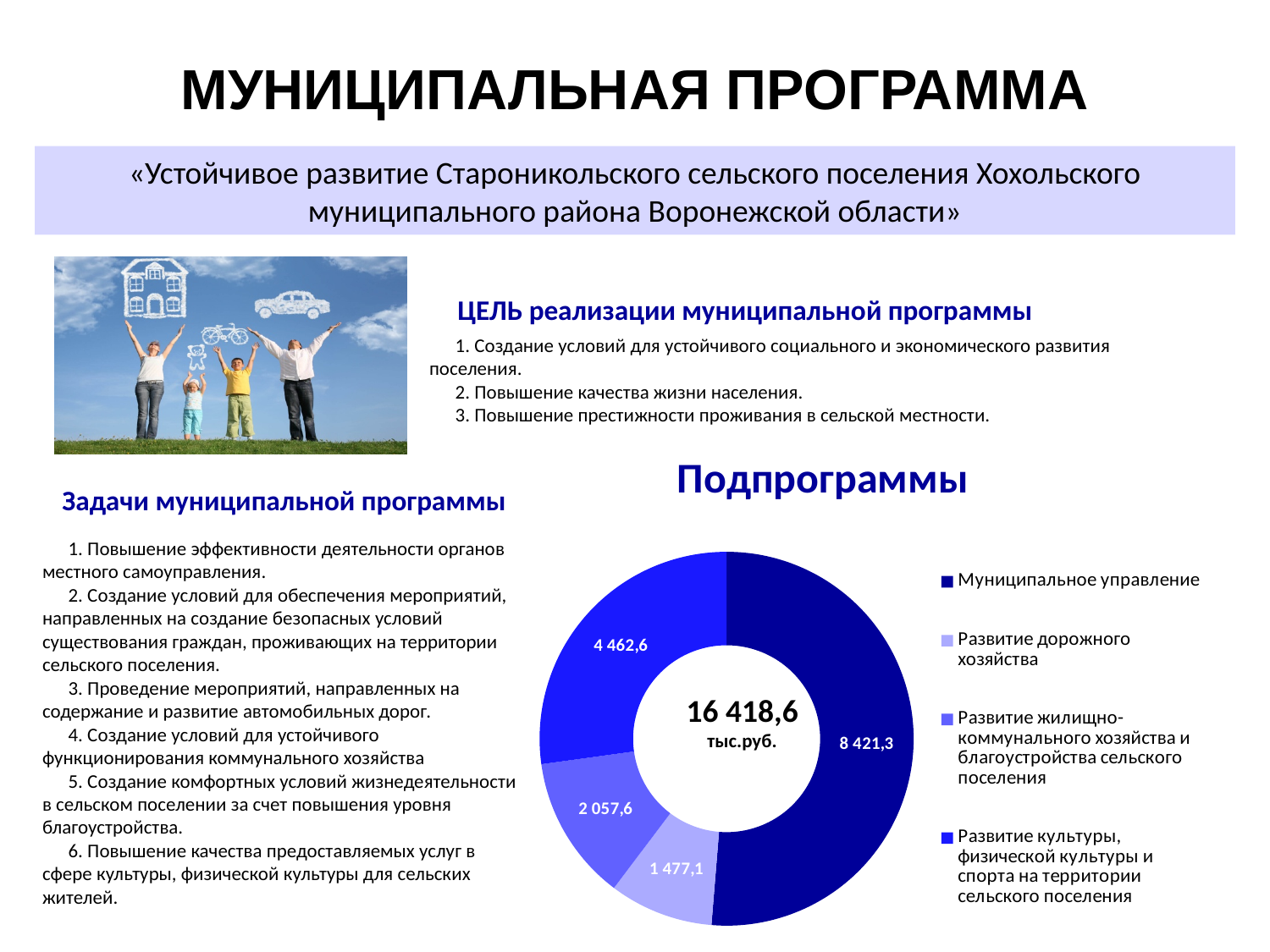
What total is shown in the centre of the «Подпрограммы» chart? 16 418,6 тыс.руб. In the «Подпрограммы» chart, which is larger: «Развитие жилищно-коммунального хозяйства» or «Развитие дорожного хозяйства»? Развитие жилищно-коммунального хозяйства What is the value for «Муниципальное управление» in the «Подпрограммы» chart? 8 421,3 What type of chart is shown under the heading «Подпрограммы»? Doughnut (pie) chart What is the value for «Развитие дорожного хозяйства» in the «Подпрограммы» chart? 1 477,1 What is the value for «Развитие жилищно-коммунального хозяйства и благоустройства сельского поселения» in the «Подпрограммы» chart? 2 057,6 In the «Подпрограммы» chart, what is the difference between «Муниципальное управление» and «Развитие культуры, физической культуры и спорта»? 3 958,7 Which subprogram has the smallest value in the «Подпрограммы» chart? Развитие дорожного хозяйства What is the value for «Развитие культуры, физической культуры и спорта на территории сельского поселения» in the «Подпрограммы» chart? 4 462,6 How many slices does the «Подпрограммы» chart have? 4 Which subprogram has the largest value in the «Подпрограммы» chart? Муниципальное управление How many entries does the legend of the «Подпрограммы» chart list? 4